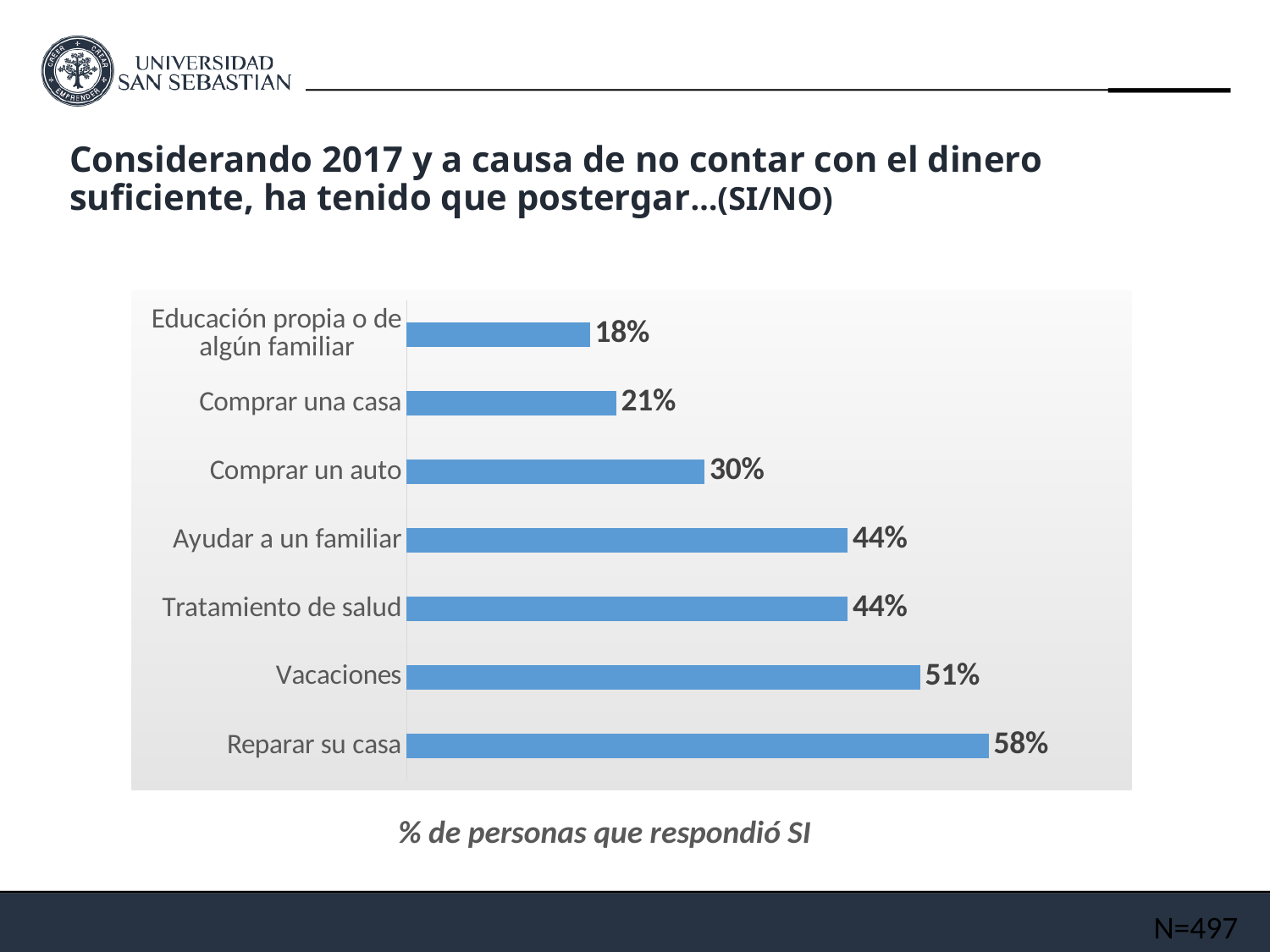
What is the caption shown below the chart? % de personas que respondió SI What is the difference between the values for "Comprar un auto" and "Comprar una casa"? 9% What is the value shown for "Comprar un auto"? 30% What is the value shown for "Educación propia o de algún familiar"? 18% How many categories are shown in the chart? 7 Which is larger, the value for "Vacaciones" or the value for "Ayudar a un familiar"? Vacaciones Which category has the highest value? Reparar su casa Which two categories share the same value of 44%? Ayudar a un familiar and Tratamiento de salud What is the difference between the values for "Reparar su casa" and "Vacaciones"? 7% Which category has the lowest value? Educación propia o de algún familiar What percentage of people answered SI for "Reparar su casa"? 58% What kind of chart is shown on the slide? Bar chart